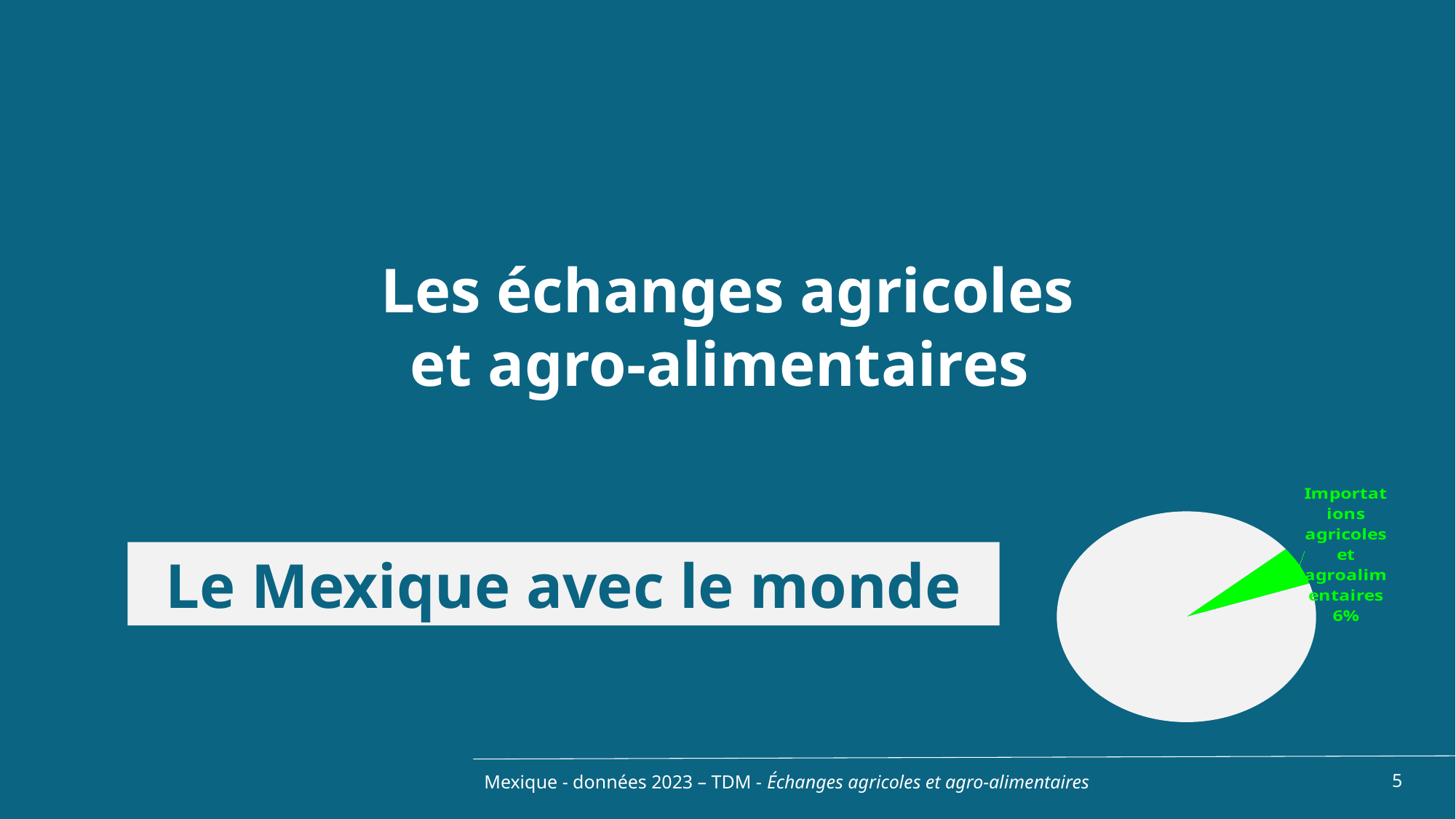
How many slices does the pie chart have? 2 Which slice of the pie chart is the smallest? Importations agricoles et agroalimentaires Is the share of the slice labelled "Importations agricoles et agroalimentaires" greater or less than 50%? less What kind of chart is shown on the slide? pie chart Which slice of the pie chart is larger, the green slice labelled "Importations agricoles et agroalimentaires" or the unlabelled white slice? the white slice What colour is the slice labelled "Importations agricoles et agroalimentaires" in the pie chart? green What is the value printed for the green slice of the pie chart? 6% What share of the pie does the slice labelled "Importations agricoles et agroalimentaires" represent? 6%